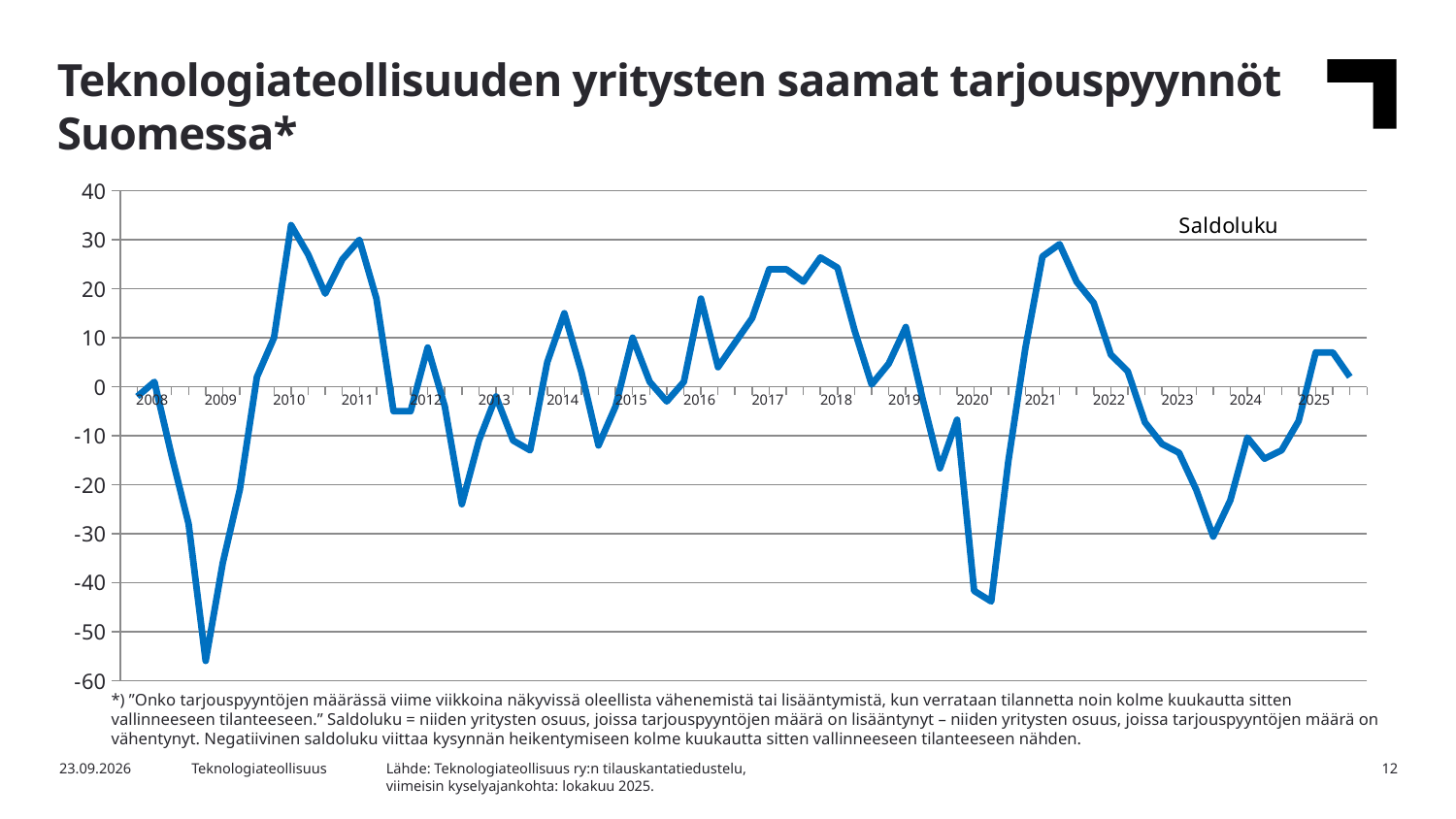
Is the lowest value of the line in 2009 greater or less than -50? less In which year does the line reach its lowest value? 2009 How many year labels are shown on the x axis? 18 Is the peak value of the line in 2010 greater or less than 30? greater What kind of chart is shown on the slide? line chart Which is larger, the peak value in 2010 or the lowest value in 2020? the peak value in 2010 What is the title of the chart on the slide? Saldoluku Does the line rise or fall between 2008 and the low point in 2009? fall Is the lowest value of the line in 2012 greater or less than -20? less